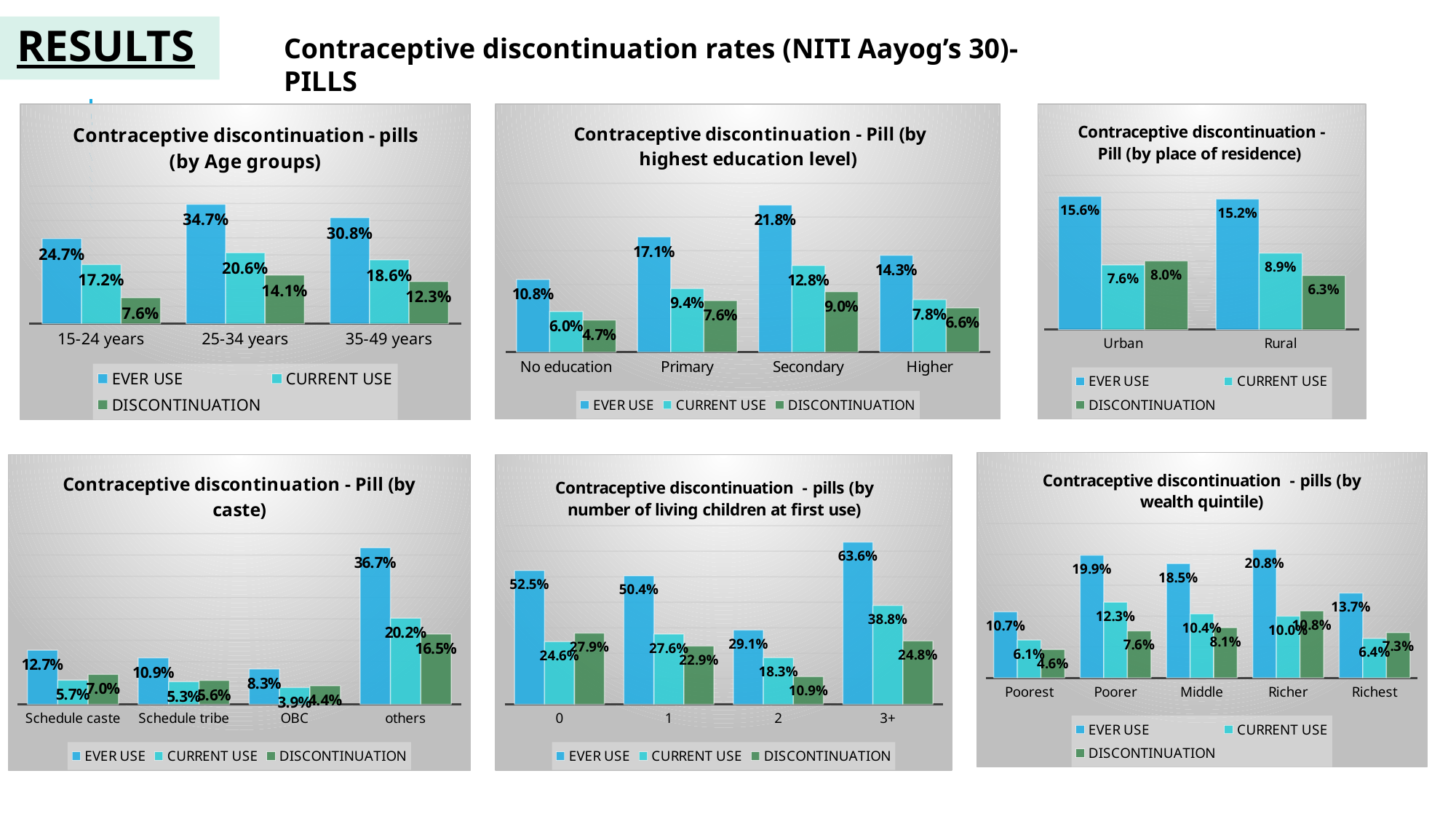
In the chart 'Contraceptive discontinuation - pills (by number of living children at first use)', which is larger, the DISCONTINUATION value for 0 or for 1? 0 In the chart 'Contraceptive discontinuation - pills (by Age groups)', which age group has the lowest DISCONTINUATION value? 15-24 years In the chart 'Contraceptive discontinuation - Pill (by place of residence)', how many series does the legend list? 3 What type of chart is 'Contraceptive discontinuation - pills (by wealth quintile)'? Bar chart In the chart 'Contraceptive discontinuation - Pill (by caste)', what is the EVER USE value for others? 36.7% In the chart 'Contraceptive discontinuation - Pill (by highest education level)', which education level has the highest EVER USE value? Secondary In the chart 'Contraceptive discontinuation - pills (by number of living children at first use)', what is the CURRENT USE value for 3+? 38.8% In the chart 'Contraceptive discontinuation - pills (by wealth quintile)', what is the CURRENT USE value for Poorer? 12.3% In the chart 'Contraceptive discontinuation - Pill (by highest education level)', what is the DISCONTINUATION value for Secondary? 9.0% In the chart 'Contraceptive discontinuation - Pill (by place of residence)', what is the difference between the CURRENT USE values for Rural and Urban? 1.3% In the chart 'Contraceptive discontinuation - pills (by Age groups)', what is the EVER USE value for 25-34 years? 34.7% In the chart 'Contraceptive discontinuation - Pill (by caste)', how many caste categories are shown on the x axis? 4